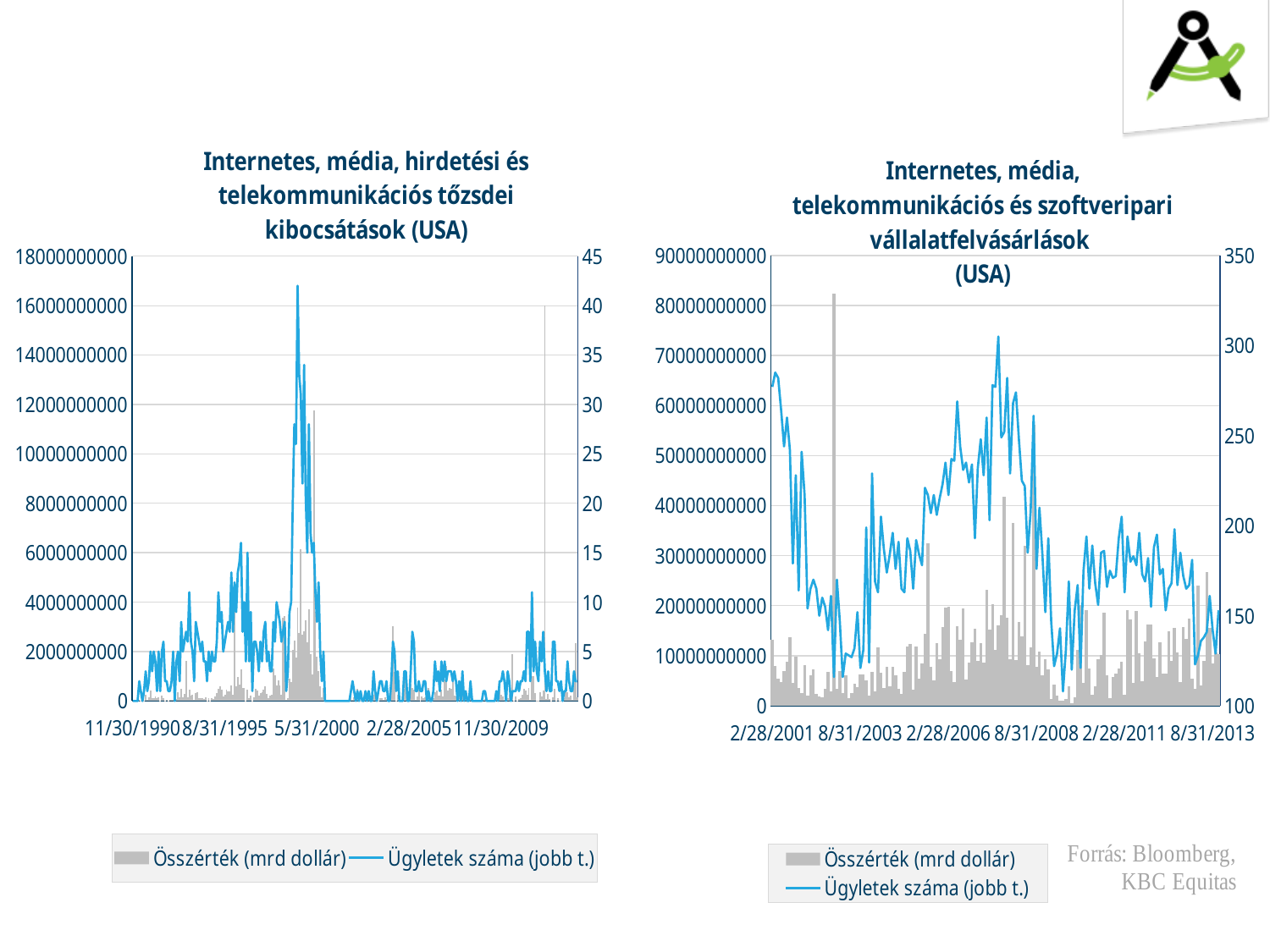
In the right chart, is the highest value of 'Ügyletek száma (jobb t.)' greater or less than 250? greater In the left chart, is the tallest 'Összérték (mrd dollár)' bar greater or less than 14000000000? greater What kind of chart is the left chart, 'Internetes, média, hirdetési és telekommunikációs tőzsdei kibocsátások (USA)'? A combined bar and line chart In the right chart, does 'Ügyletek száma (jobb t.)' rise or fall between 2/28/2001 and 8/31/2003? fall What is the first date label on the x axis of the right chart? 2/28/2001 In the right chart, is the tallest 'Összérték (mrd dollár)' bar greater or less than 70000000000? greater How many series does the legend of the right chart, 'Internetes, média, telekommunikációs és szoftveripari vállalatfelvásárlások (USA)', list? 2 What is the maximum value shown on the right-hand axis of the left chart? 45 Which chart has the taller maximum 'Összérték (mrd dollár)' bar, the left chart or the right chart? The right chart How many series does the legend of the left chart list? 2